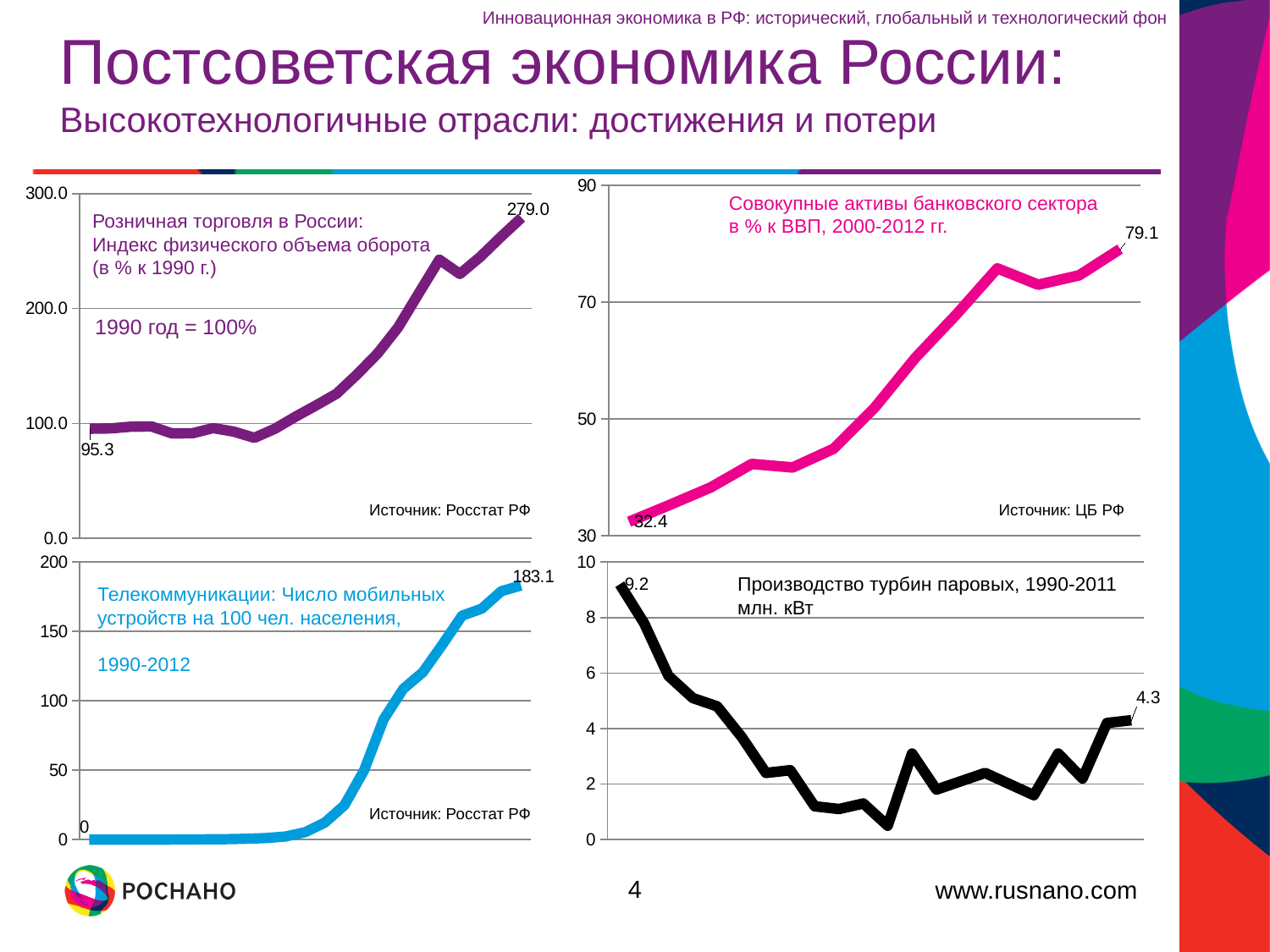
On the bottom-left chart (Телекоммуникации), what is the value labelled at the start of the line? 0 On the bottom-left chart (Телекоммуникации), what is the value labelled at the end of the line? 183.1 On the bottom-right chart (Производство турбин паровых), what is the value labelled at the end of the line? 4.3 On the top-right chart (Совокупные активы банковского сектора), do the values generally rise or fall from left to right? rise On the top-left chart (Розничная торговля в России), what is the value labelled at the start of the line? 95.3 On the top-left chart (Розничная торговля в России), what is the difference between the last labelled value and the first labelled value? 183.7 On the top-right chart (Совокупные активы банковского сектора), what is the value labelled at the end of the line? 79.1 On the top-right chart (Совокупные активы банковского сектора), what is the value labelled at the start of the line? 32.4 What kind of chart is the bottom-right chart (Производство турбин паровых)? line chart On the bottom-right chart (Производство турбин паровых), what is the value labelled at the start of the line? 9.2 On the top-left chart (Розничная торговля в России), what is the value labelled at the end of the line? 279.0 On the bottom-right chart (Производство турбин паровых), which is larger: the first labelled value or the last labelled value? the first labelled value (9.2)